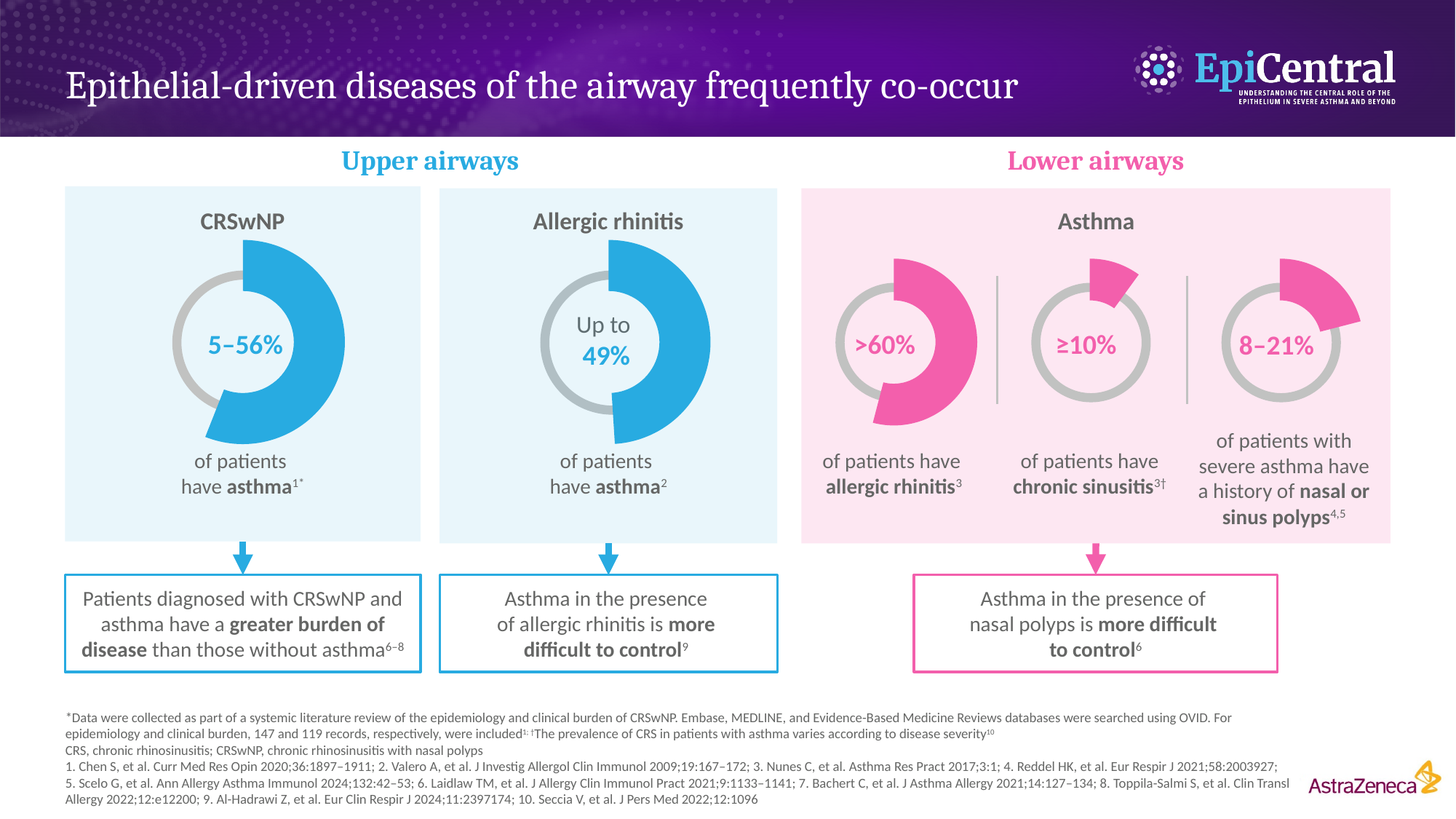
On the Asthma panel under Lower airways, what percentage of patients with severe asthma have a history of nasal or sinus polyps? 8–21% What colour are the donut charts under the Upper airways heading? blue How many donut charts are shown under the Lower airways heading? 3 On the Allergic rhinitis chart under Upper airways, what percentage of patients have asthma? Up to 49% On the CRSwNP chart under Upper airways, what percentage of patients have asthma? 5–56% On the Asthma panel under Lower airways, what percentage of patients have chronic sinusitis? ≥10% How many donut charts are shown on the slide in total? 5 On the Asthma panel under Lower airways, which is larger: the share of patients with allergic rhinitis or the share with chronic sinusitis? allergic rhinitis On the Asthma panel under Lower airways, what percentage of patients have allergic rhinitis? >60% What kind of chart is used to show the percentages on this slide? donut chart What colour are the donut charts under the Lower airways heading? pink On the Asthma panel under Lower airways, which of the three charts shows the highest percentage? allergic rhinitis